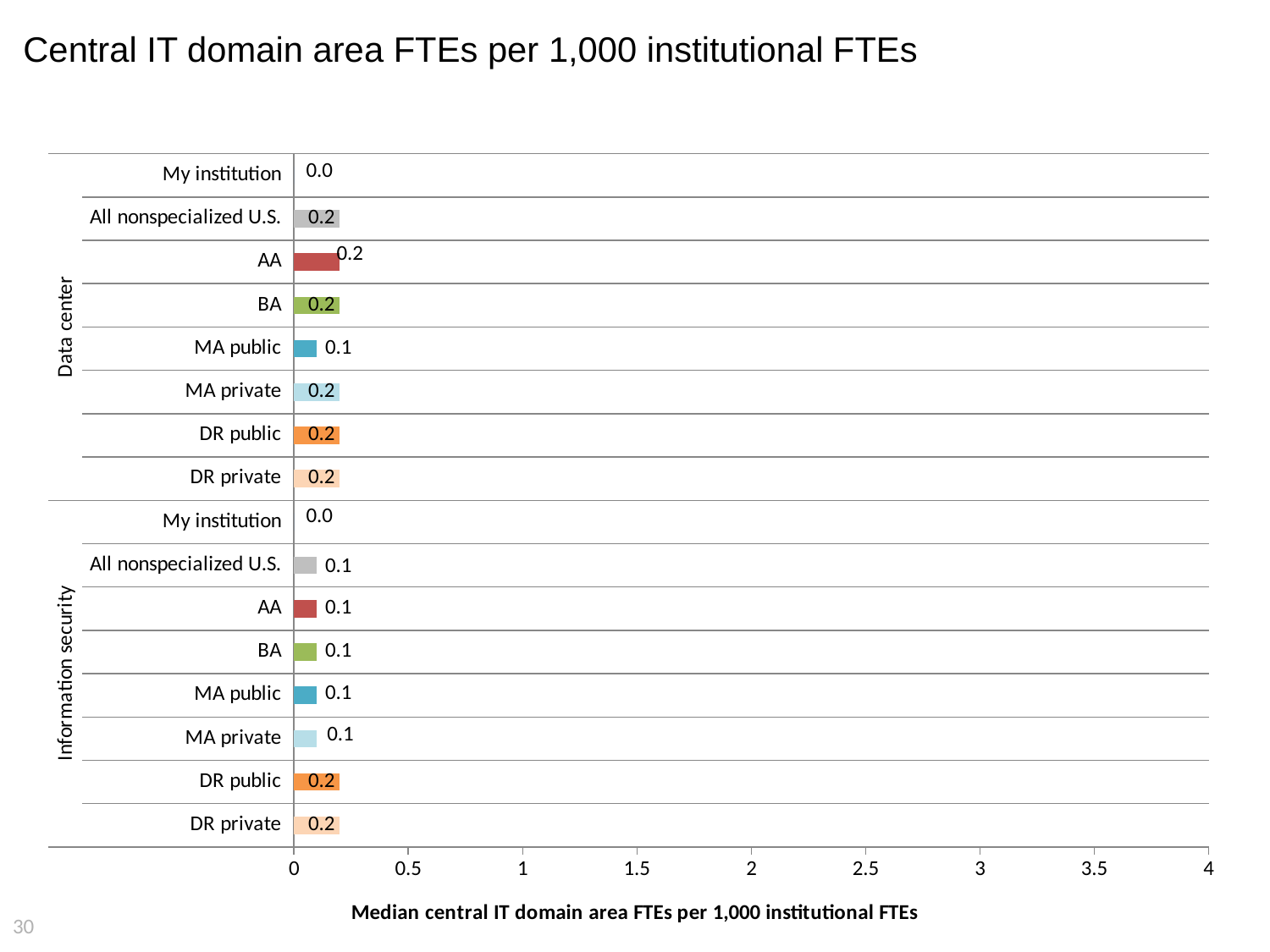
What is the value for MA public in the Data center group? 0.1 What is the maximum value shown on the x axis? 4 What is the value for My institution in the Data center group? 0.0 What is the difference between the Data center value for AA and the Information security value for AA? 0.1 What is the value for BA in the Data center group? 0.2 What is the value for DR public in the Information security group? 0.2 What is the value for All nonspecialized U.S. in the Information security group? 0.1 Which category has the lowest value in the Information security group? My institution What kind of chart is shown on the slide? Bar chart What is the title of the x axis? Median central IT domain area FTEs per 1,000 institutional FTEs Which is larger: the Data center value for MA private or the Information security value for MA private? Data center How many categories are shown in the Data center group? 8